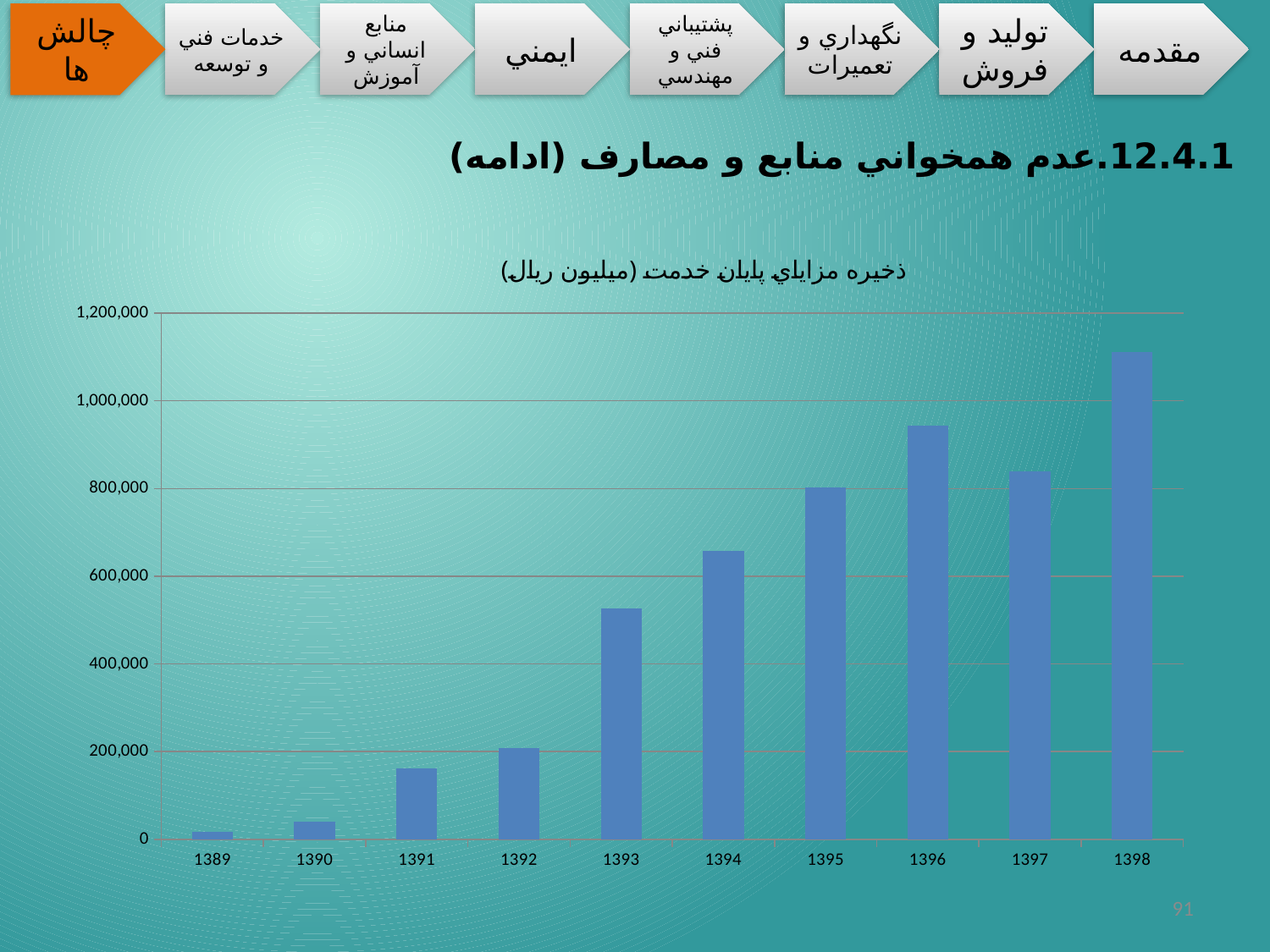
Which year has the lowest bar in the chart? 1389 Is the value for 1391 greater or less than 200,000? less Is the value for 1398 greater or less than 1,000,000? greater Which is larger, the value for 1396 or the value for 1397? 1396 How many years (bars) are shown on the x axis of the chart? 10 What kind of chart is shown on the slide? bar chart Which year has the highest bar in the chart? 1398 Is the value for 1393 greater or less than 400,000? greater Do the values generally rise or fall from 1389 to 1398? rise What is the title of the chart? ذخيره مزاياي پايان خدمت (ميليون ريال)